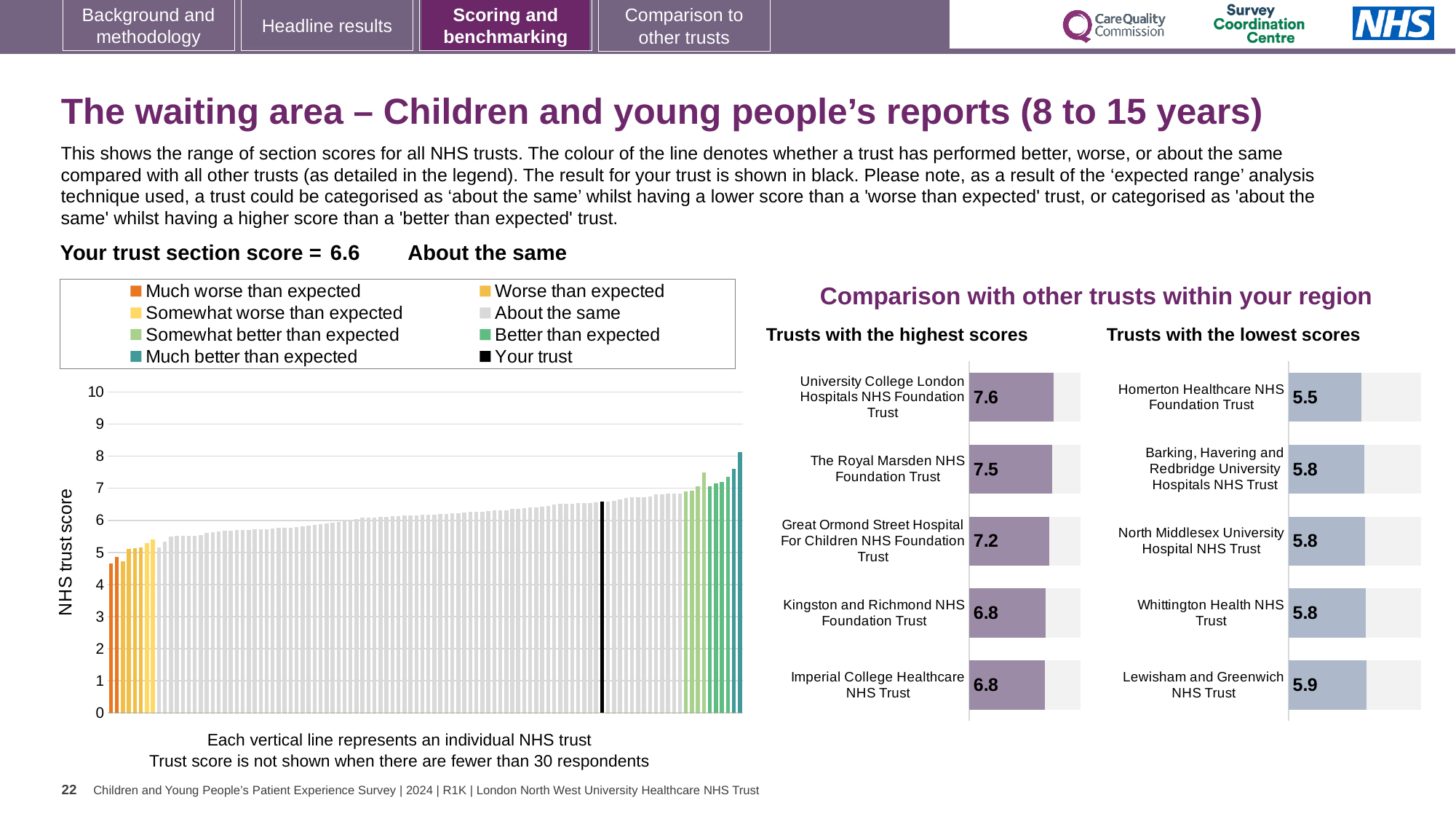
In the large chart on the left, do the bar values rise or fall from left to right? rise In the 'Trusts with the lowest scores' chart, what is the score for Homerton Healthcare NHS Foundation Trust? 5.5 In the 'Trusts with the highest scores' chart, what is the difference between the scores of University College London Hospitals NHS Foundation Trust and Great Ormond Street Hospital For Children NHS Foundation Trust? 0.4 In the 'Trusts with the highest scores' chart, what is the score for The Royal Marsden NHS Foundation Trust? 7.5 In the large chart on the left, is the value of the lowest (leftmost) bar greater or less than 5? less In the large chart on the left, what is the section score for your trust (the black bar)? 6.6 How many entries does the legend above the large chart on the left list? 8 In the 'Trusts with the highest scores' chart, which trust has the highest score? University College London Hospitals NHS Foundation Trust In the 'Trusts with the lowest scores' chart, which has the larger score: Lewisham and Greenwich NHS Trust or Homerton Healthcare NHS Foundation Trust? Lewisham and Greenwich NHS Trust In the 'Trusts with the lowest scores' chart, how many trusts are shown? 5 What kind of chart is the large chart on the left showing all NHS trusts? bar chart What is the y-axis label of the large chart on the left? NHS trust score